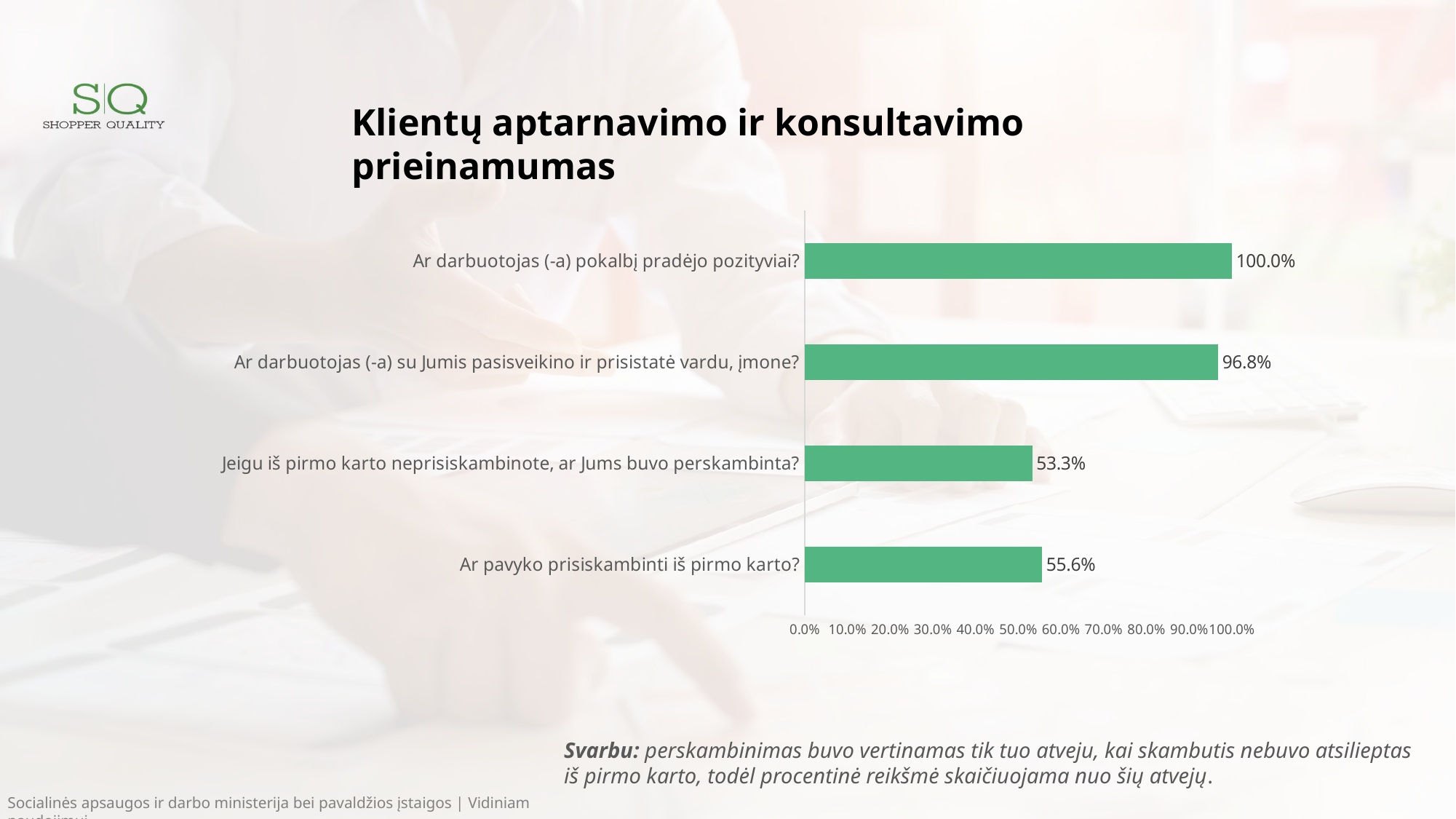
How many categories are shown in the chart? 4 What is the value for "Ar darbuotojas (-a) su Jumis pasisveikino ir prisistatė vardu, įmone?"? 96.8% What kind of chart is shown on the slide? Bar chart Which category has the highest value? Ar darbuotojas (-a) pokalbį pradėjo pozityviai? What is the difference between the values for "Ar darbuotojas (-a) pokalbį pradėjo pozityviai?" and "Ar darbuotojas (-a) su Jumis pasisveikino ir prisistatė vardu, įmone?"? 3.2 percentage points What is the value for "Jeigu iš pirmo karto neprisiskambinote, ar Jums buvo perskambinta?"? 53.3% What is the value for "Ar darbuotojas (-a) pokalbį pradėjo pozityviai?"? 100.0% Which category has the lowest value? Jeigu iš pirmo karto neprisiskambinote, ar Jums buvo perskambinta? What is the value for "Ar pavyko prisiskambinti iš pirmo karto?"? 55.6% Is the value for "Jeigu iš pirmo karto neprisiskambinote, ar Jums buvo perskambinta?" greater or less than 60.0%? less What is the difference between the values for "Ar pavyko prisiskambinti iš pirmo karto?" and "Jeigu iš pirmo karto neprisiskambinote, ar Jums buvo perskambinta?"? 2.3 percentage points Which is larger: the value for "Ar pavyko prisiskambinti iš pirmo karto?" or for "Jeigu iš pirmo karto neprisiskambinote, ar Jums buvo perskambinta?"? Ar pavyko prisiskambinti iš pirmo karto?